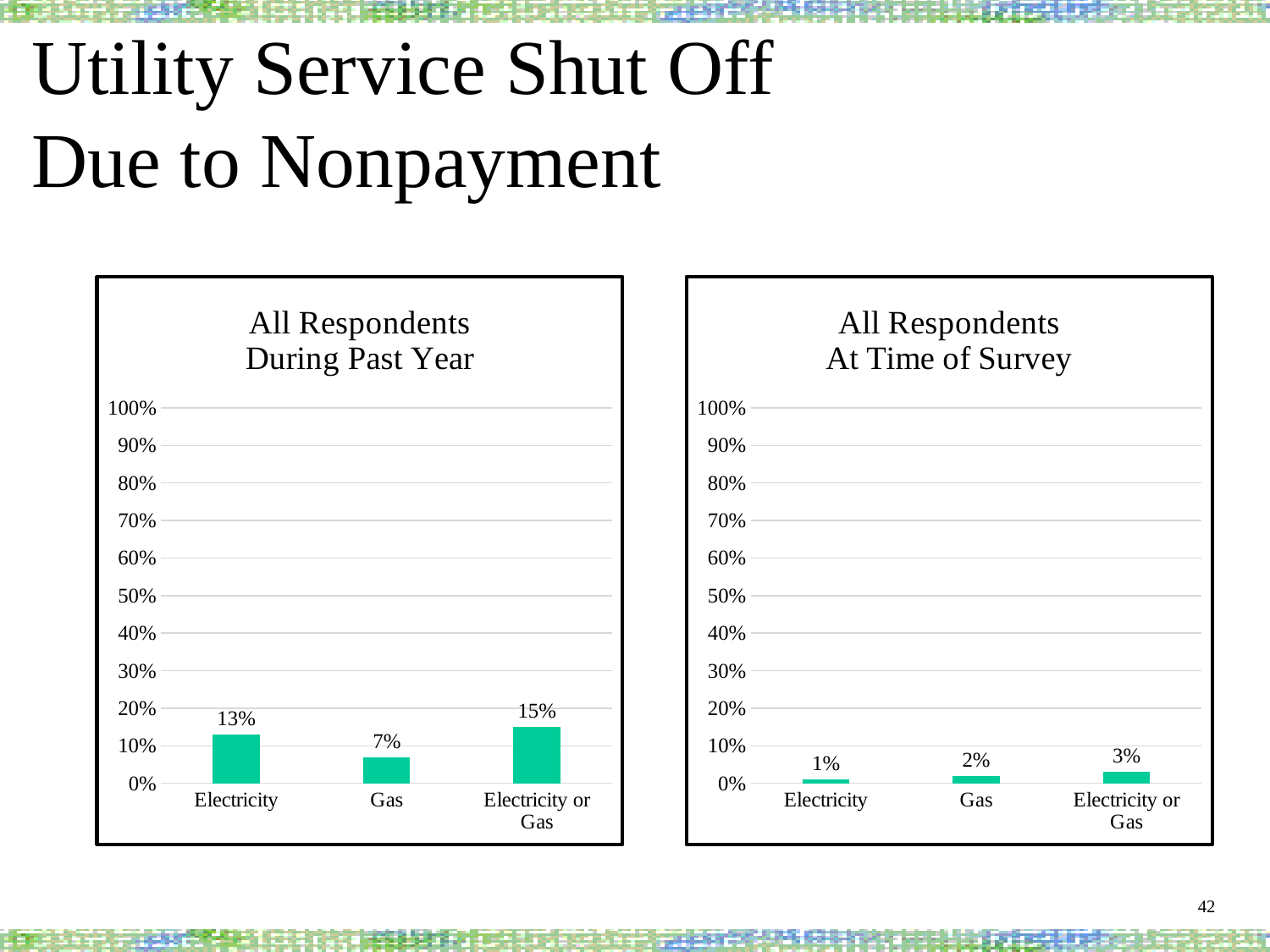
In the 'All Respondents At Time of Survey' chart, which category has the lowest value? Electricity In the 'All Respondents During Past Year' chart, what is the value for Gas? 7% What kind of chart is the 'All Respondents During Past Year' chart? bar chart In the 'All Respondents At Time of Survey' chart, what is the value for Electricity? 1% In the 'All Respondents At Time of Survey' chart, which is larger, the value for Gas or the value for Electricity? Gas In the 'All Respondents During Past Year' chart, what is the value for Electricity? 13% How many categories are shown in the 'All Respondents At Time of Survey' chart? 3 In the 'All Respondents During Past Year' chart, what is the difference between the values for Electricity or Gas and Gas? 8% In the 'All Respondents During Past Year' chart, is the value for Electricity greater or less than 10%? greater In the 'All Respondents During Past Year' chart, which category has the lowest value? Gas In the 'All Respondents At Time of Survey' chart, what is the value for Electricity or Gas? 3% In the 'All Respondents During Past Year' chart, which category has the highest value? Electricity or Gas